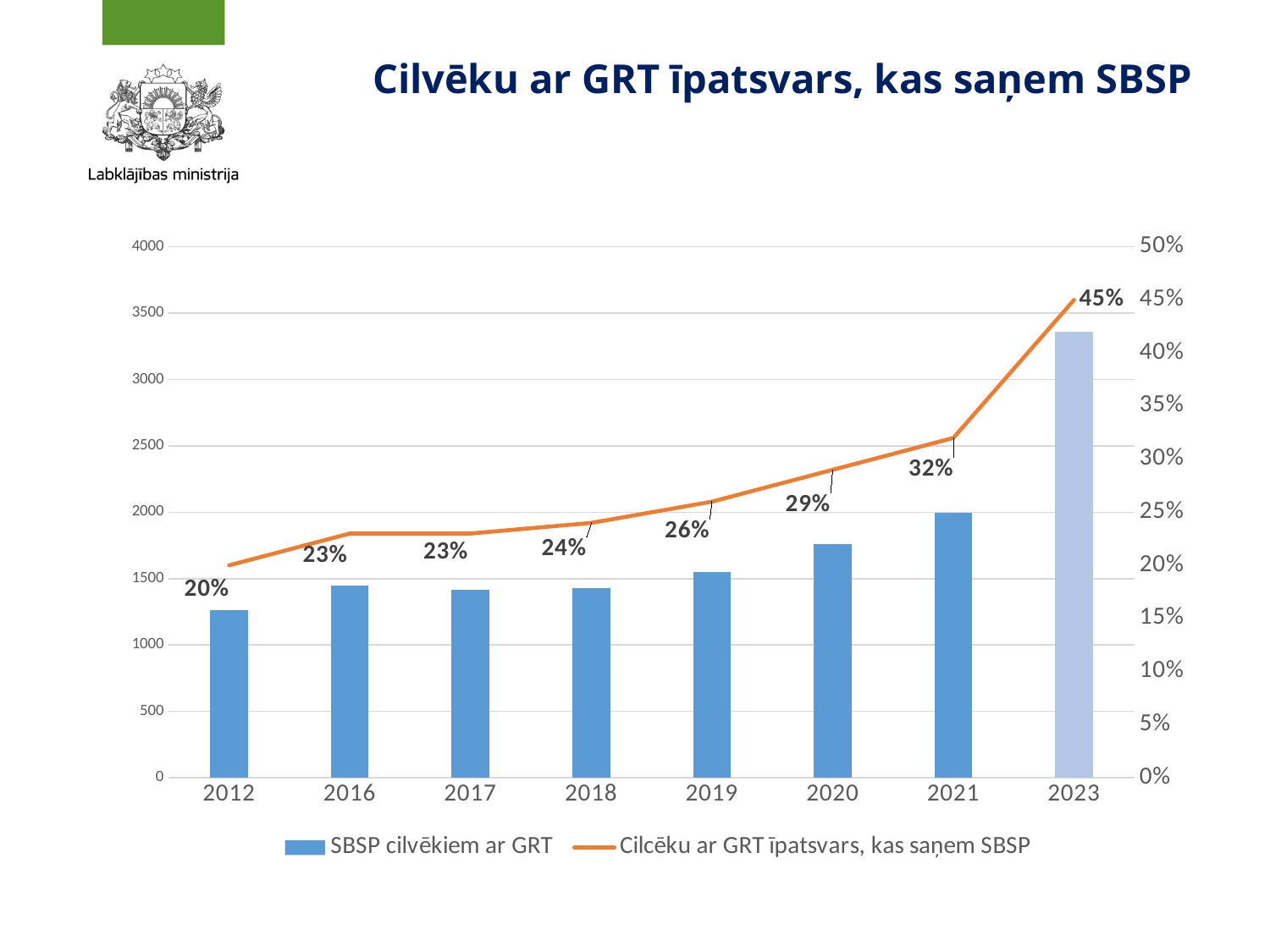
What percentage is shown on the line for 2012? 20% Which year has the highest percentage on the line series? 2023 Is the bar value for 'SBSP cilvēkiem ar GRT' in 2023 greater or less than 3000? greater Does the line series rise or fall from 2012 to 2023? rise How many series does the legend list? 2 Which year has the lowest percentage on the line series? 2012 Is the line percentage for 2019 higher or lower than for 2021? lower What percentage is shown on the line for 2020? 29% What is the difference between the line percentage for 2023 and for 2021? 13% What is the value of the 'Cilcēku ar GRT īpatsvars, kas saņem SBSP' line for 2023? 45% How many years are shown on the x axis? 8 Is the bar value for 'SBSP cilvēkiem ar GRT' in 2012 greater or less than 1500? less